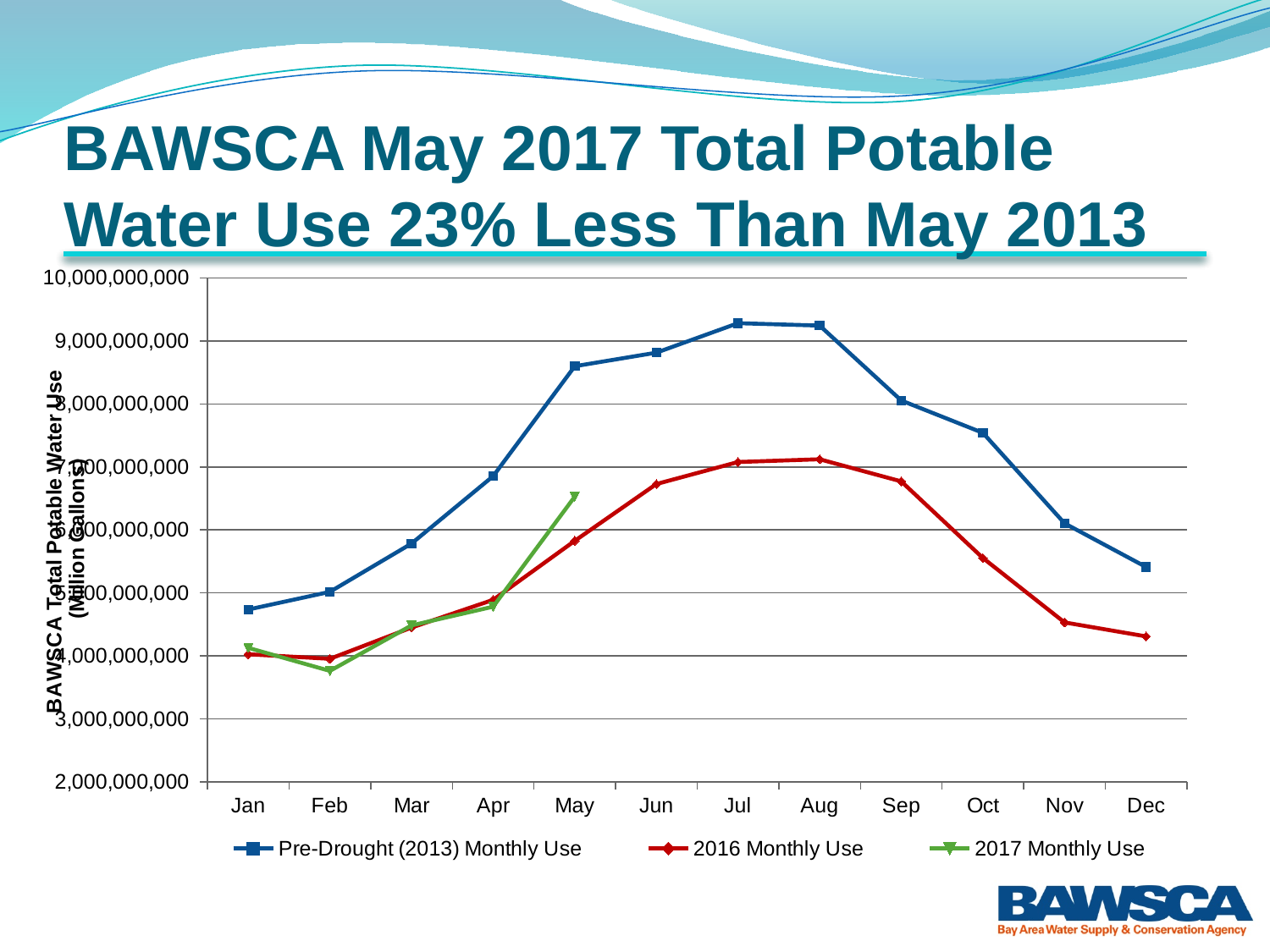
Through which month does the 2017 Monthly Use series extend? May Is the 2017 Monthly Use value for Feb greater or less than 4,000,000,000? less How many months are shown along the x axis? 12 Does the 2017 Monthly Use series rise or fall from Feb to May? Rise How many series does the legend list? 3 In May, which series has the larger value: Pre-Drought (2013) Monthly Use or 2016 Monthly Use? Pre-Drought (2013) Monthly Use In which month is the Pre-Drought (2013) Monthly Use series at its lowest value? Jan Is the 2016 Monthly Use value for Dec greater or less than 5,000,000,000? less Is the 2017 Monthly Use value for May greater or less than 6,000,000,000? greater In which month does the Pre-Drought (2013) Monthly Use series reach its highest value? Jul What kind of chart is shown on the slide? Line chart